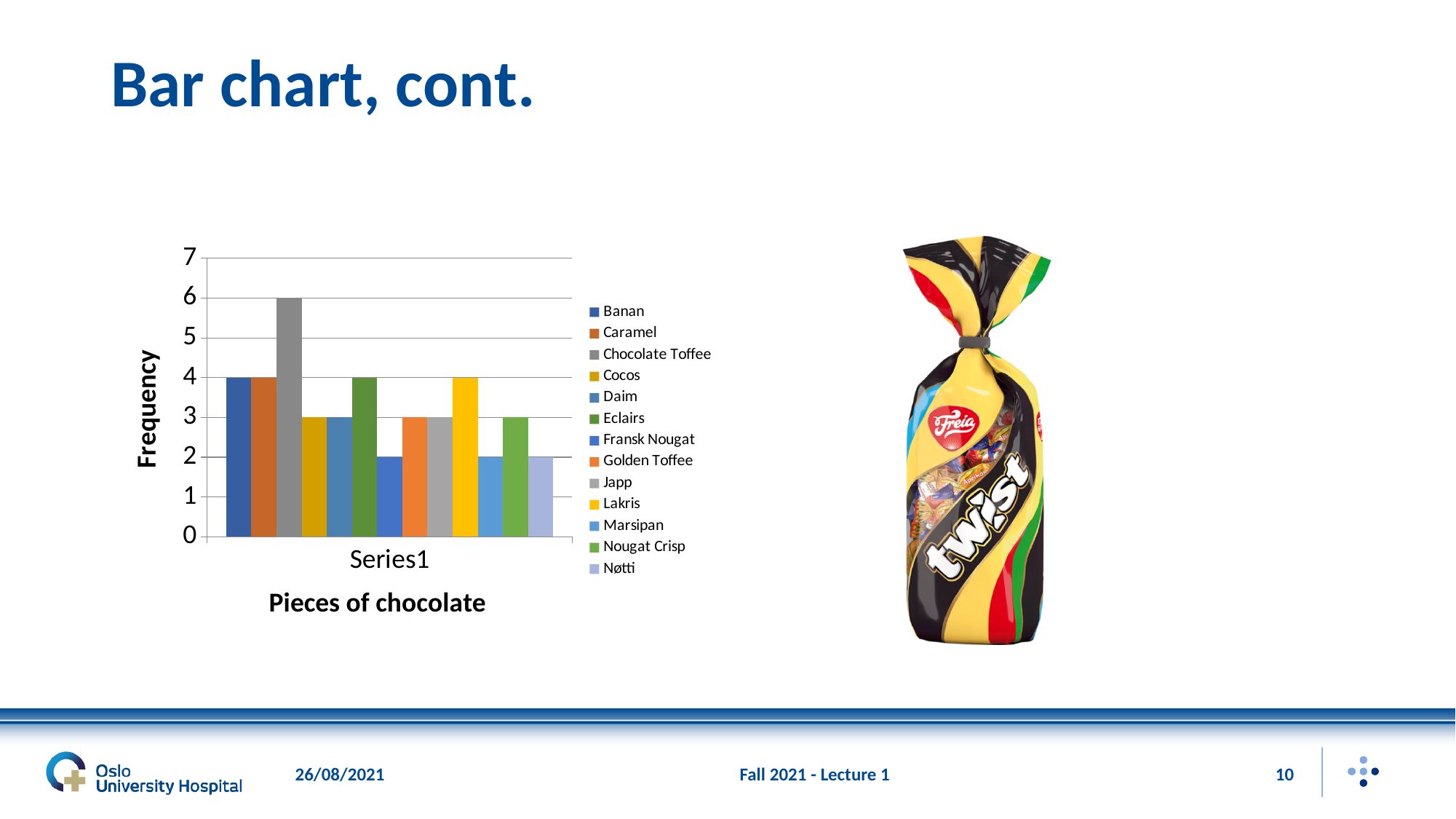
What kind of chart is shown on the slide? bar chart What is the label on the horizontal axis? Pieces of chocolate What is the frequency for Lakris? 4 Which chocolate has the highest frequency? Chocolate Toffee Is the frequency for Chocolate Toffee greater or less than 5? greater What is the frequency for Fransk Nougat? 2 What is the difference in frequency between Chocolate Toffee and Nøtti? 4 Which has a higher frequency, Eclairs or Marsipan? Eclairs What is the frequency for Chocolate Toffee? 6 What is the label on the vertical axis? Frequency How many entries does the legend list? 13 What is the frequency for Banan? 4